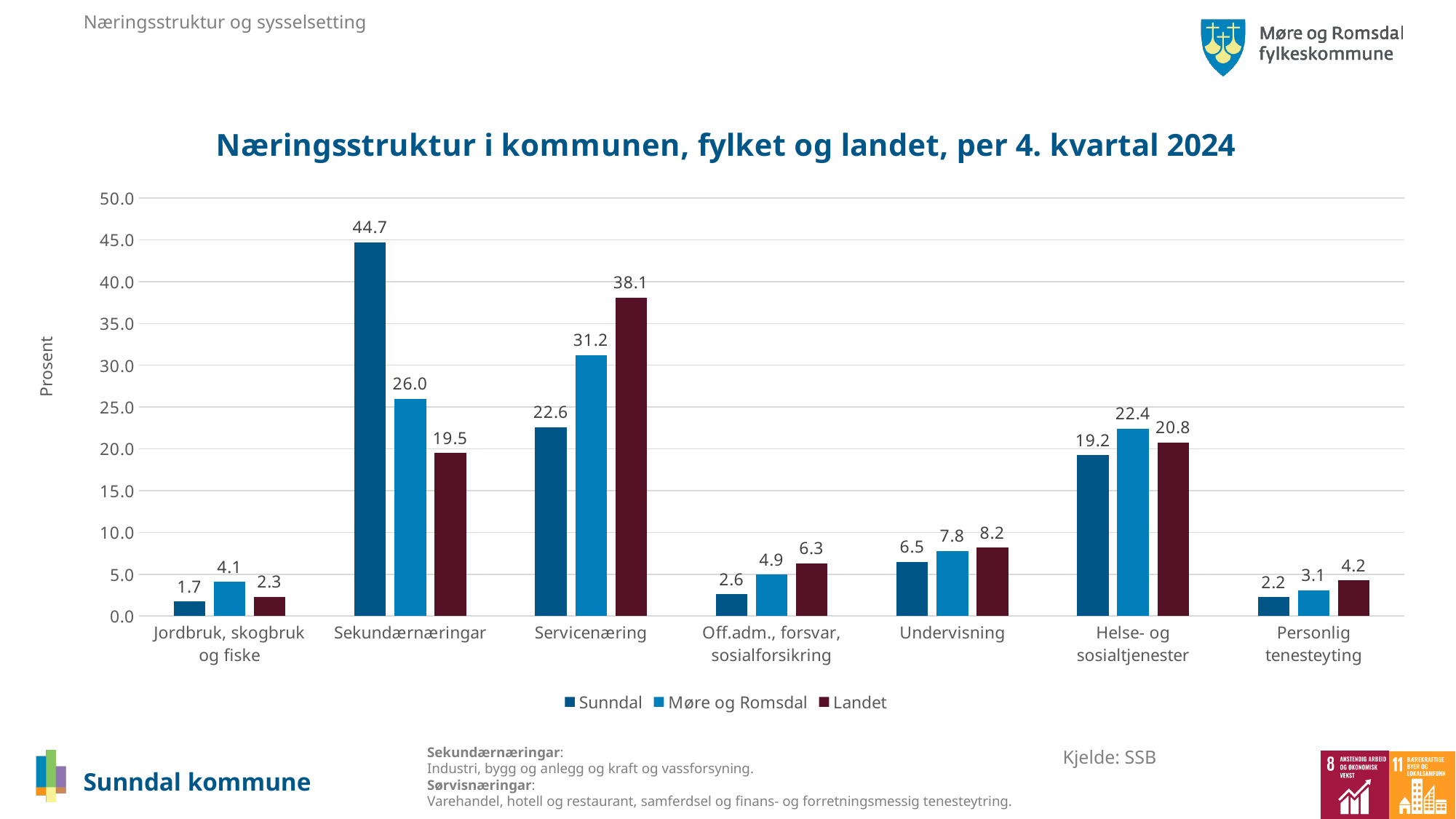
Is the value for Møre og Romsdal in Sekundærnæringar greater or less than 30.0? less How many categories are shown on the x axis? 7 Which category has the highest value for Sunndal? Sekundærnæringar How many series does the legend list? 3 What is the value for Sunndal in Sekundærnæringar? 44.7 Which is larger in Servicenæring: the value for Sunndal or for Møre og Romsdal? Møre og Romsdal What is the difference between the Sunndal and Landet values in Sekundærnæringar? 25.2 What is the title of the chart? Næringsstruktur i kommunen, fylket og landet, per 4. kvartal 2024 What is the value for Møre og Romsdal in Helse- og sosialtjenester? 22.4 Which category has the lowest value for Landet? Jordbruk, skogbruk og fiske What is the value for Landet in Servicenæring? 38.1 What kind of chart is shown on the slide? bar chart